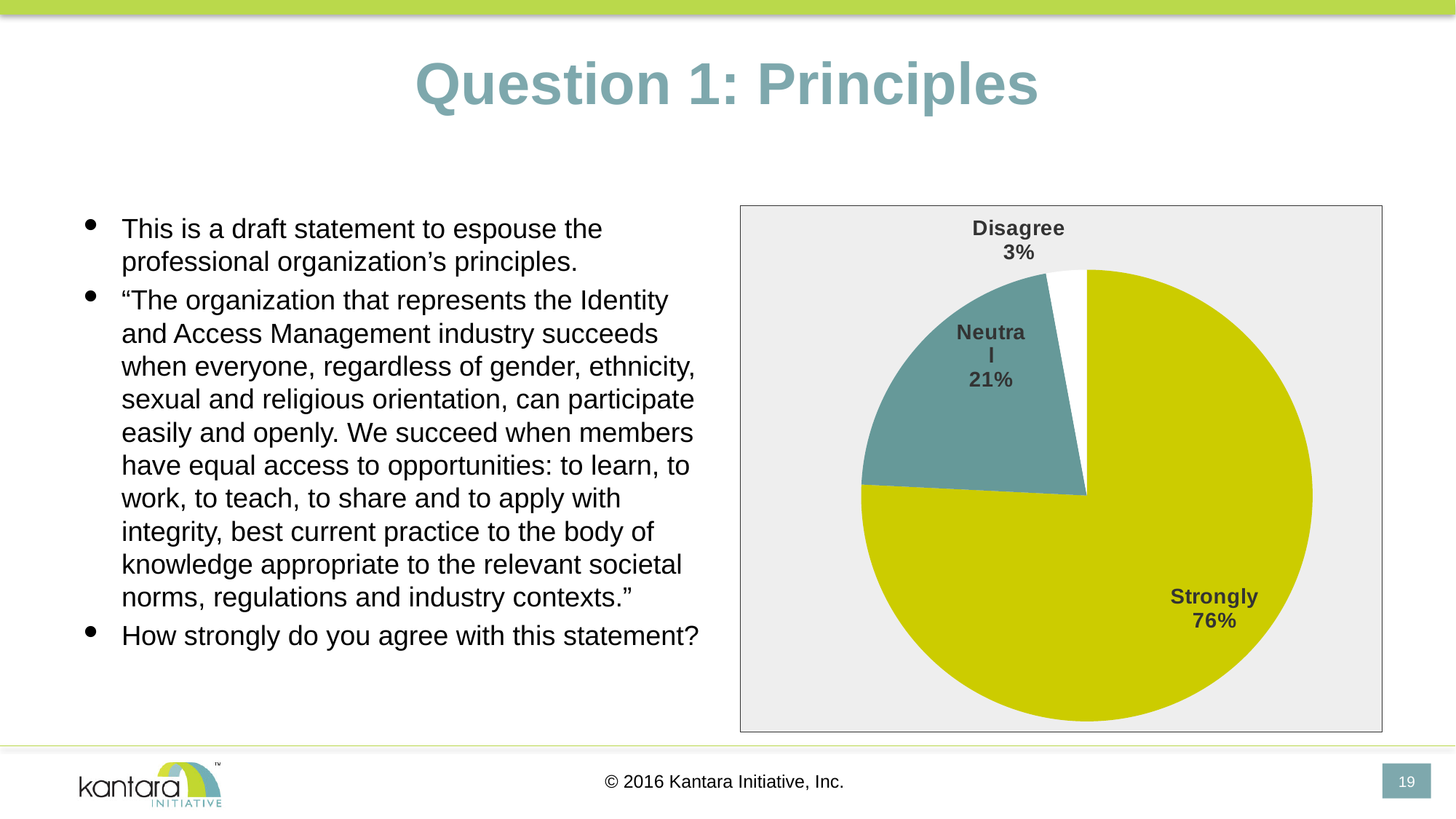
Which is larger, the Neutral slice or the Disagree slice? Neutral What share of the pie is labelled Neutral? 21% What colour is the Strongly slice of the pie chart? yellow-green What share of the pie is labelled Strongly? 76% How many slices does the pie chart have? 3 Which slice of the pie chart is the largest? Strongly What share of the pie is labelled Disagree? 3% What is the difference in percentage points between the Strongly and Neutral slices? 55 Which slice of the pie chart is the smallest? Disagree What kind of chart is shown on the slide? pie chart What colour is the Neutral slice of the pie chart? teal What is the difference in percentage points between the Neutral and Disagree slices? 18